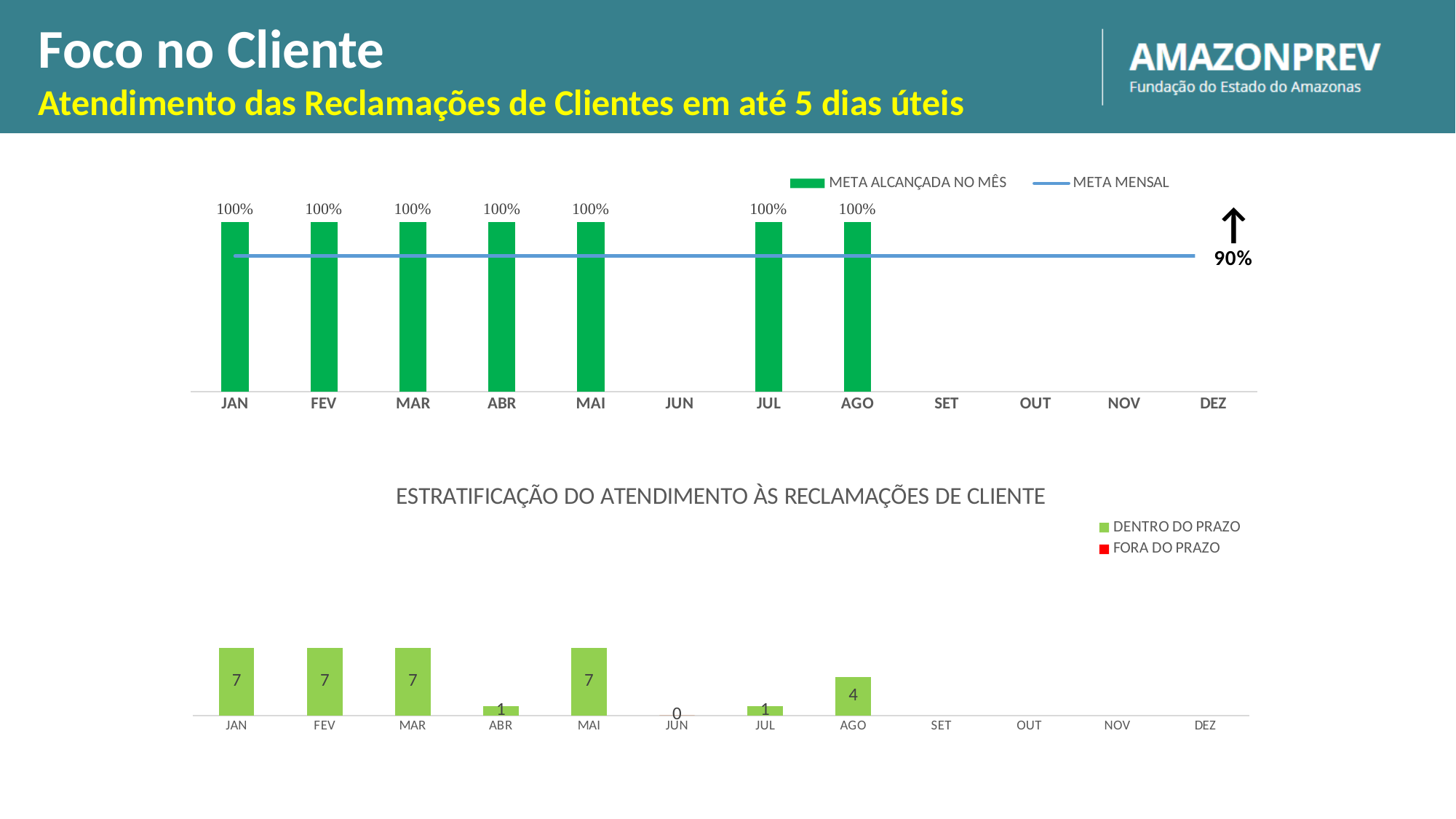
In the chart titled ESTRATIFICAÇÃO DO ATENDIMENTO ÀS RECLAMAÇÕES DE CLIENTE, what is the DENTRO DO PRAZO value for JUN? 0 In the top chart, how many series does the legend list? 2 In the chart titled ESTRATIFICAÇÃO DO ATENDIMENTO ÀS RECLAMAÇÕES DE CLIENTE, which is larger, the DENTRO DO PRAZO value for AGO or for JUL? AGO In the top chart, what is the value of META ALCANÇADA NO MÊS for JAN? 100% In the chart titled ESTRATIFICAÇÃO DO ATENDIMENTO ÀS RECLAMAÇÕES DE CLIENTE, what is the difference between the DENTRO DO PRAZO values for MAI and AGO? 3 In the chart titled ESTRATIFICAÇÃO DO ATENDIMENTO ÀS RECLAMAÇÕES DE CLIENTE, what colour is the DENTRO DO PRAZO series in the legend? Green In the chart titled ESTRATIFICAÇÃO DO ATENDIMENTO ÀS RECLAMAÇÕES DE CLIENTE, what is the DENTRO DO PRAZO value for AGO? 4 In the chart titled ESTRATIFICAÇÃO DO ATENDIMENTO ÀS RECLAMAÇÕES DE CLIENTE, what kind of chart is shown? Bar chart In the top chart, how many months are labelled on the x axis? 12 In the chart titled ESTRATIFICAÇÃO DO ATENDIMENTO ÀS RECLAMAÇÕES DE CLIENTE, what is the DENTRO DO PRAZO value for ABR? 1 In the top chart, what is the value of META ALCANÇADA NO MÊS for AGO? 100% In the top chart, what is the META MENSAL value shown next to the arrow? 90%